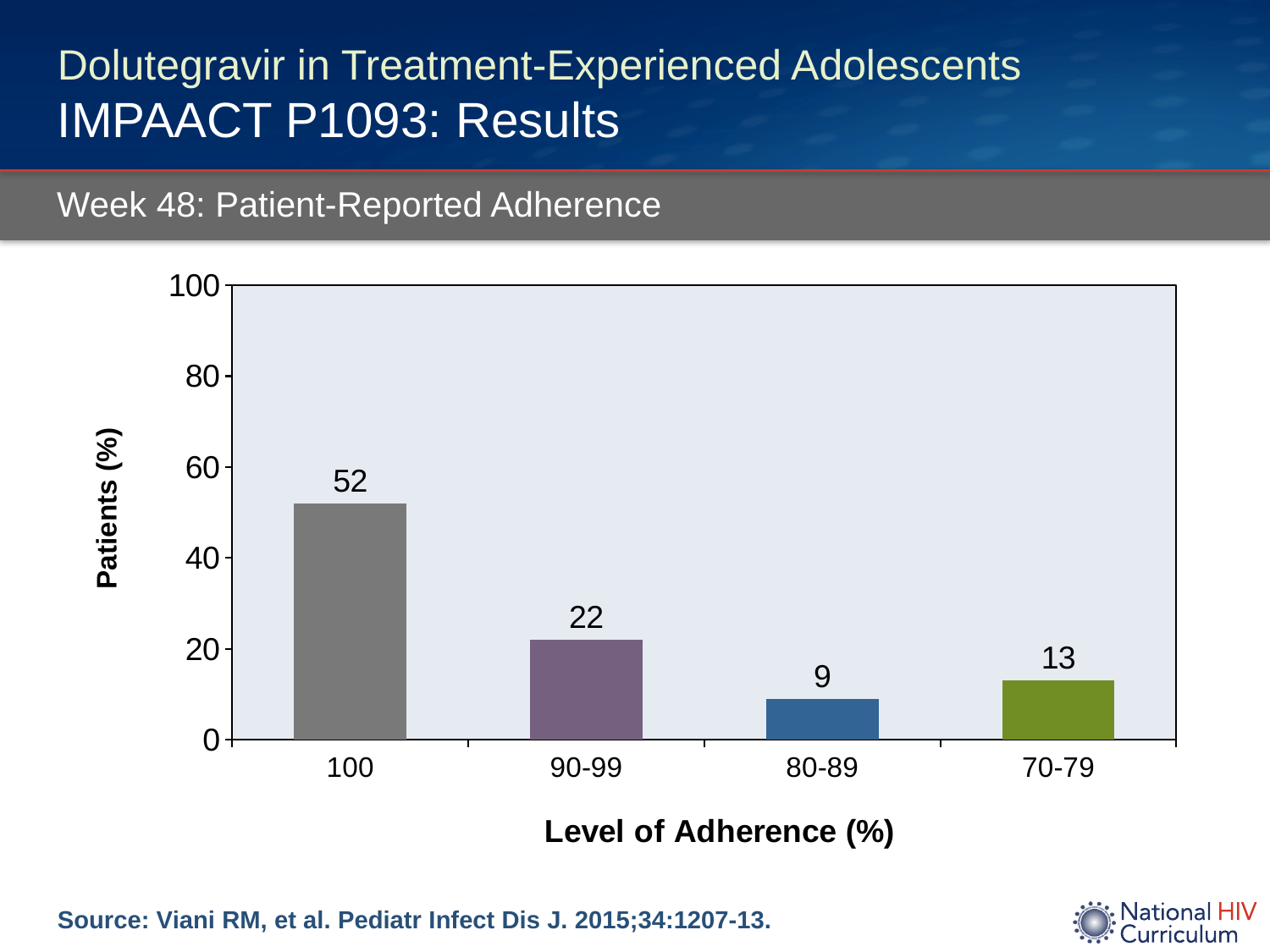
What is the label of the x axis? Level of Adherence (%) What kind of chart is shown on the slide? Bar chart What percentage of patients reported an adherence level of 80-89? 9 What percentage of patients reported 100% adherence? 52 What is the value for the 70-79 adherence category? 13 Which has a larger value: the 70-79 category or the 80-89 category? 70-79 Which level of adherence has the lowest percentage of patients? 80-89 What is the value for the 90-99 level of adherence? 22 How many adherence categories are shown on the x axis? 4 What is the difference between the values for the 100 and 90-99 adherence categories? 30 What is the label of the y axis? Patients (%) Which level of adherence has the highest percentage of patients? 100